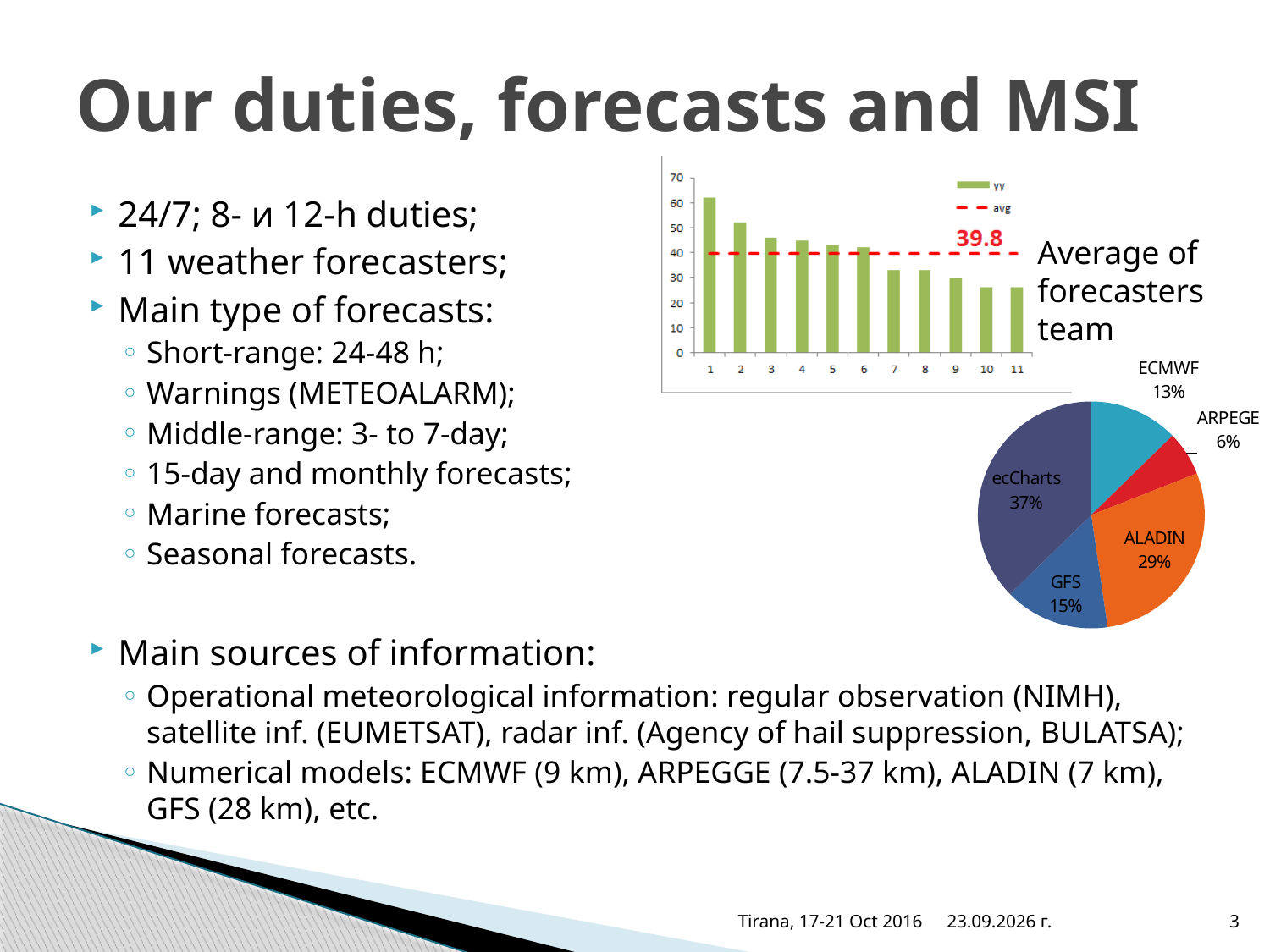
In the bar chart at the top right, is the value for category 1 greater or less than 50? greater In the bar chart at the top right, how many bars are plotted along the x axis? 11 In the bar chart at the top right, what value is printed for the average (avg) line? 39.8 In the bar chart at the top right, is the value for category 7 greater or less than 40? less In the bar chart at the top right, do the bar values generally rise or fall from category 1 to category 11? fall In the bar chart at the top right, how many entries does the legend list? 2 In the pie chart at the bottom right, what share does ecCharts have? 37% In the bar chart at the top right, which is larger, the value for category 2 or the value for category 9? category 2 In the pie chart at the bottom right, what is the difference between the ecCharts share and the ALADIN share? 8% In the bar chart at the top right, which category has the highest bar? 1 In the pie chart at the bottom right, how many slices are there? 5 In the pie chart at the bottom right, which slice is the smallest? ARPEGE